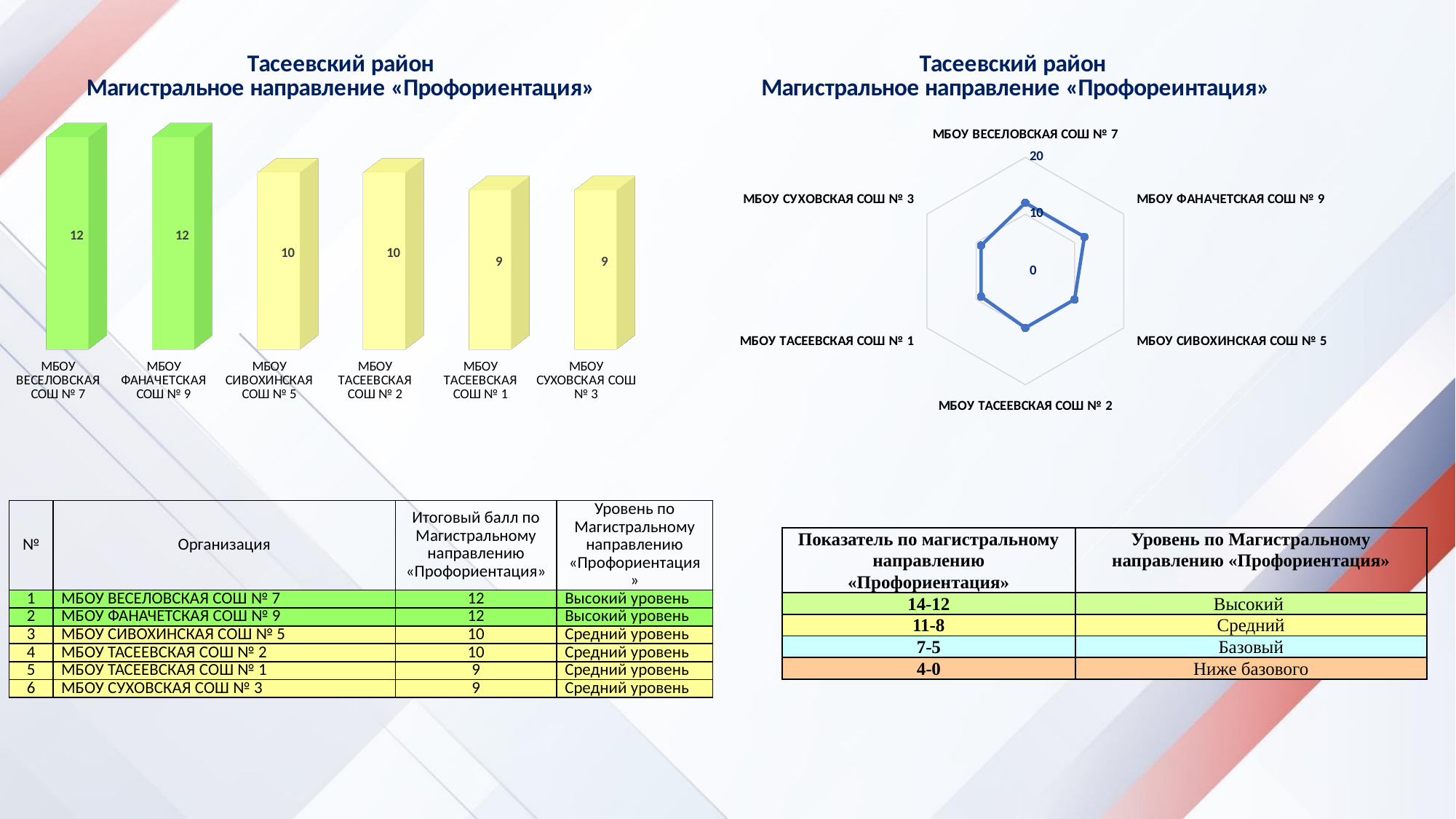
In the bar chart on the left, what is the highest value shown? 12 In the bar chart on the left, what is the lowest value shown? 9 In the radar chart on the right, is the value for МБОУ ТАСЕЕВСКАЯ СОШ № 2 greater or less than 20? less In the bar chart on the left, what is the value for МБОУ СИВОХИНСКАЯ СОШ № 5? 10 What type of chart is the chart on the right side of the slide? radar chart How many bars are in the bar chart on the left? 6 In the bar chart on the left, what is the difference between the values for МБОУ ФАНАЧЕТСКАЯ СОШ № 9 and МБОУ ТАСЕЕВСКАЯ СОШ № 1? 3 In the bar chart on the left, what is the value for МБОУ ВЕСЕЛОВСКАЯ СОШ № 7? 12 How many axes (categories) does the radar chart on the right have? 6 In the bar chart on the left, what is the value for МБОУ СУХОВСКАЯ СОШ № 3? 9 What type of chart is the chart on the left side of the slide? bar chart In the bar chart on the left, which has a larger value: МБОУ ФАНАЧЕТСКАЯ СОШ № 9 or МБОУ СУХОВСКАЯ СОШ № 3? МБОУ ФАНАЧЕТСКАЯ СОШ № 9